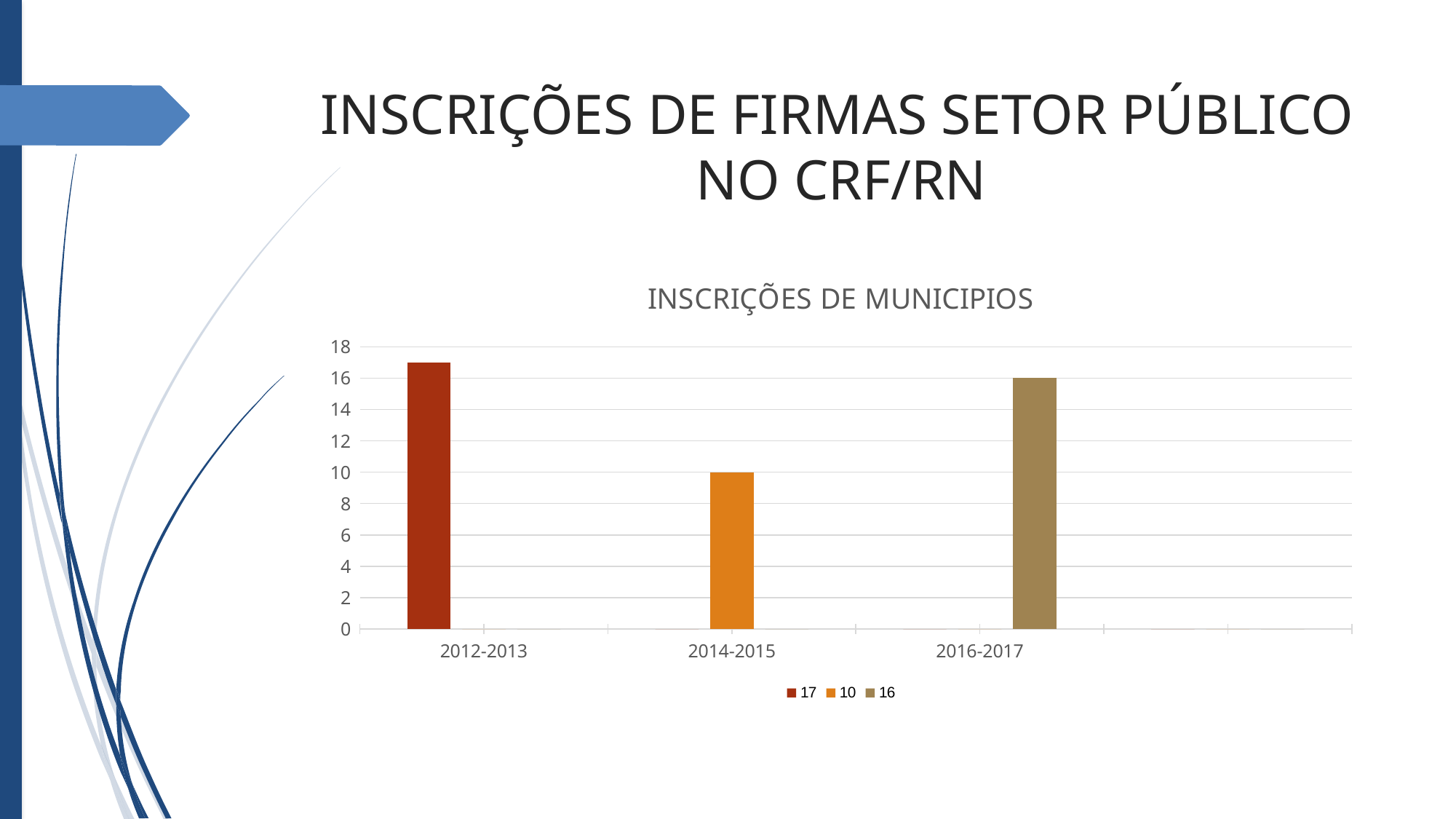
Which period has the lowest value? 2014-2015 Which period has the highest value? 2012-2013 What kind of chart is shown on the slide? bar chart How many categories are shown on the x axis of the chart? 3 Is the value for 2012-2013 greater or less than 16? greater What is the difference between the values for 2016-2017 and 2014-2015? 6 Which is larger, the value for 2014-2015 or the value for 2016-2017? 2016-2017 Does the value fall or rise from 2012-2013 to 2014-2015? falls What is the title of the chart? INSCRIÇÕES DE MUNICIPIOS What is the value for 2014-2015? 10 How many entries does the chart's legend list? 3 What is the value for 2016-2017? 16